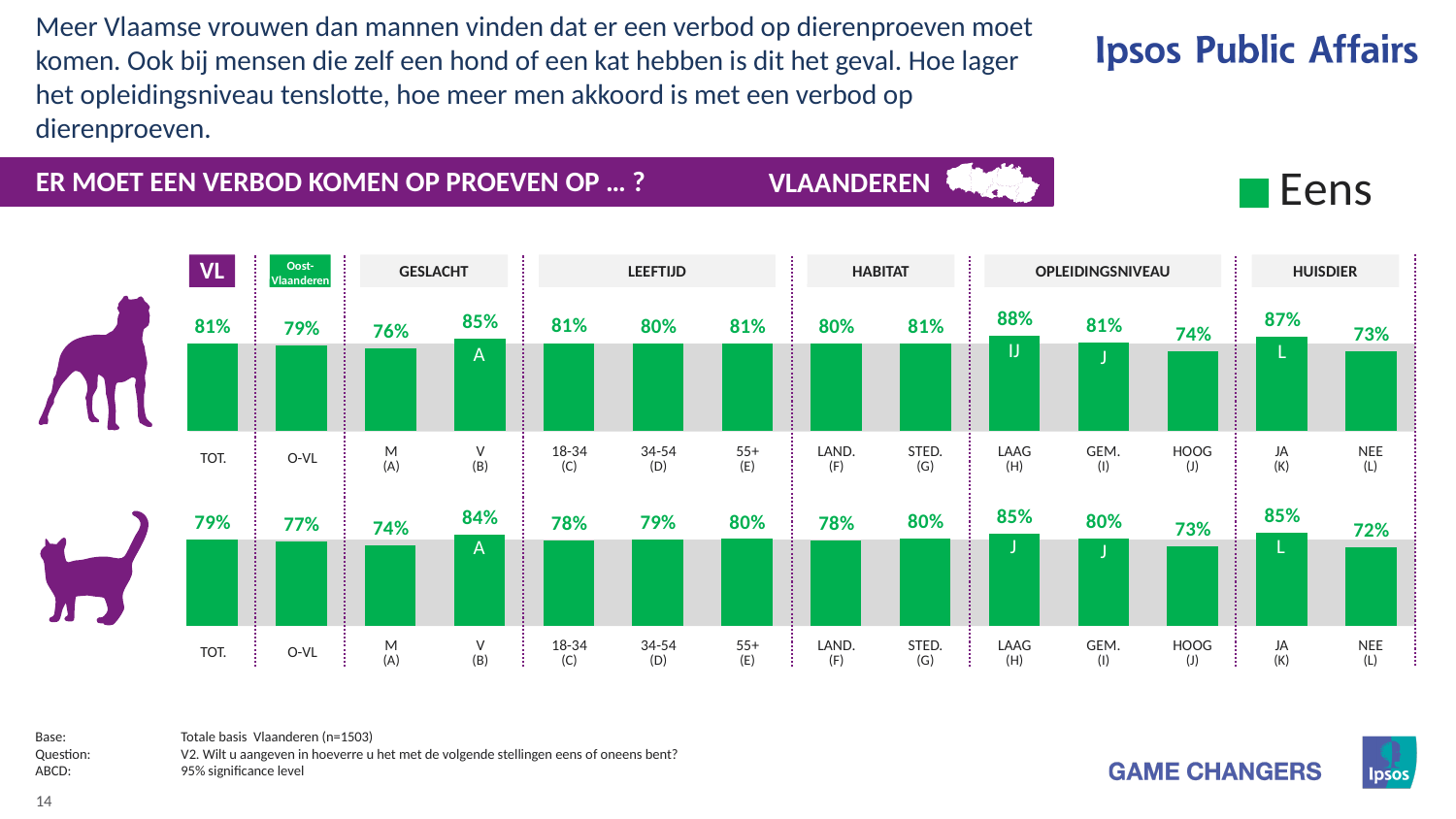
In the top row (dog) chart, which category under OPLEIDINGSNIVEAU has the highest value? LAAG (H) In the top row (dog) chart, what is the value for O-VL? 79% How many bars are shown in the top row (dog) chart? 14 In the top row (dog) chart, what is the difference between JA (K) and NEE (L) under HUISDIER? 14 percentage points What series does the legend list? Eens In the top row (dog) chart, what is the value for TOT.? 81% In the bottom row (cat) chart, what is the value for V (B) under GESLACHT? 84% In the bottom row (cat) chart, what is the value for 55+ (E) under LEEFTIJD? 80% In the bottom row (cat) chart, which category under HUISDIER has the lowest value? NEE (L) In the bottom row (cat) chart, which is larger: LAAG (H) or HOOG (J) under OPLEIDINGSNIVEAU? LAAG (H) In the top row (dog) chart, what is the difference between V (B) and M (A) under GESLACHT? 9 percentage points What kind of chart is used on this slide? Bar chart